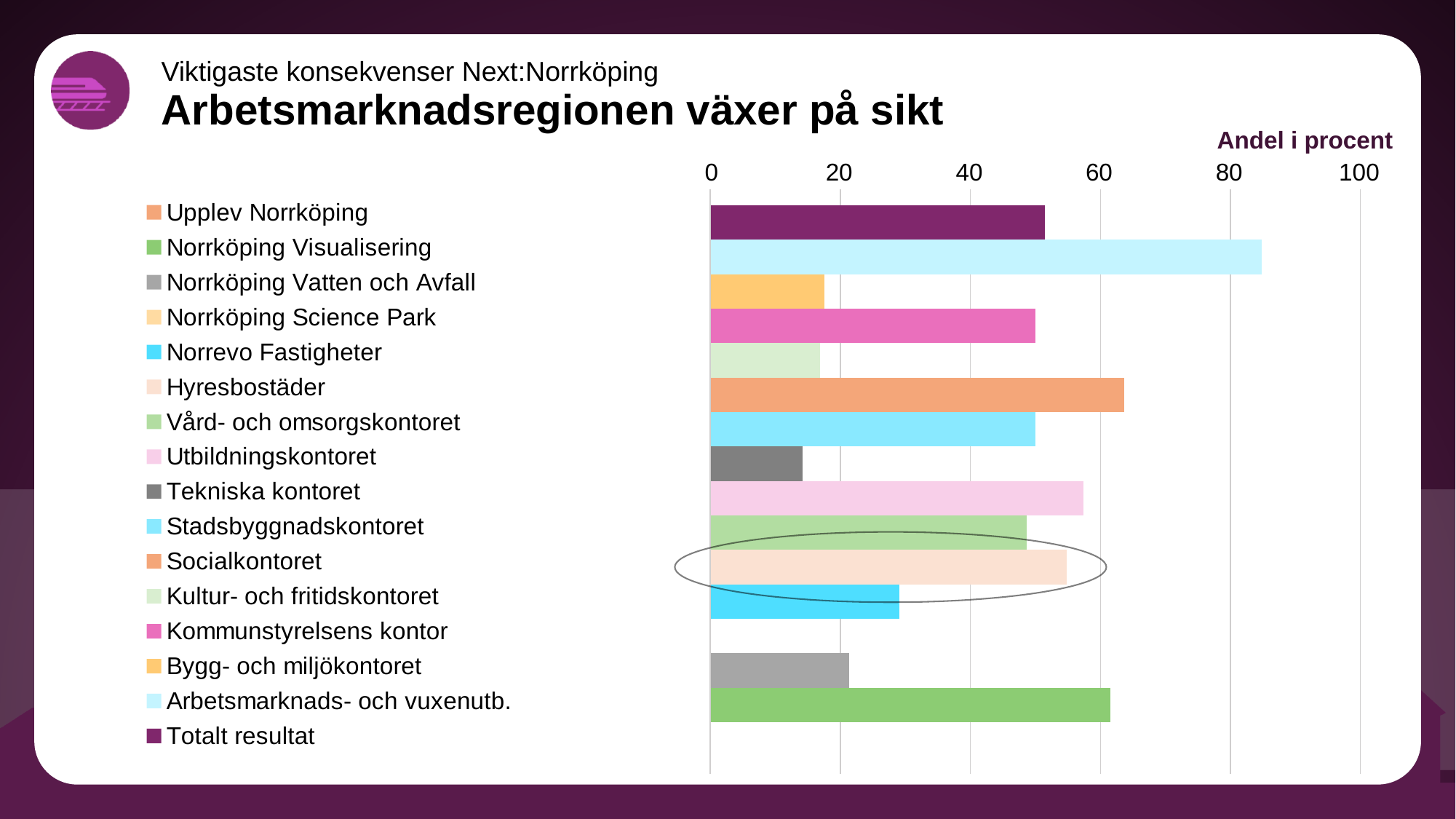
What kind of chart is shown on the slide? bar chart Which is larger, the value for Socialkontoret or the value for Totalt resultat? Socialkontoret Is the value for Totalt resultat greater or less than 40? greater How many entries does the chart legend list? 16 Is the value for Arbetsmarknads- och vuxenutb. greater or less than 80? greater Is the value for Tekniska kontoret greater or less than 20? less Which is larger, the value for Arbetsmarknads- och vuxenutb. or the value for Norrköping Visualisering? Arbetsmarknads- och vuxenutb. Which category has the longest bar in the chart? Arbetsmarknads- och vuxenutb. What is the label shown above the horizontal axis of the chart? Andel i procent